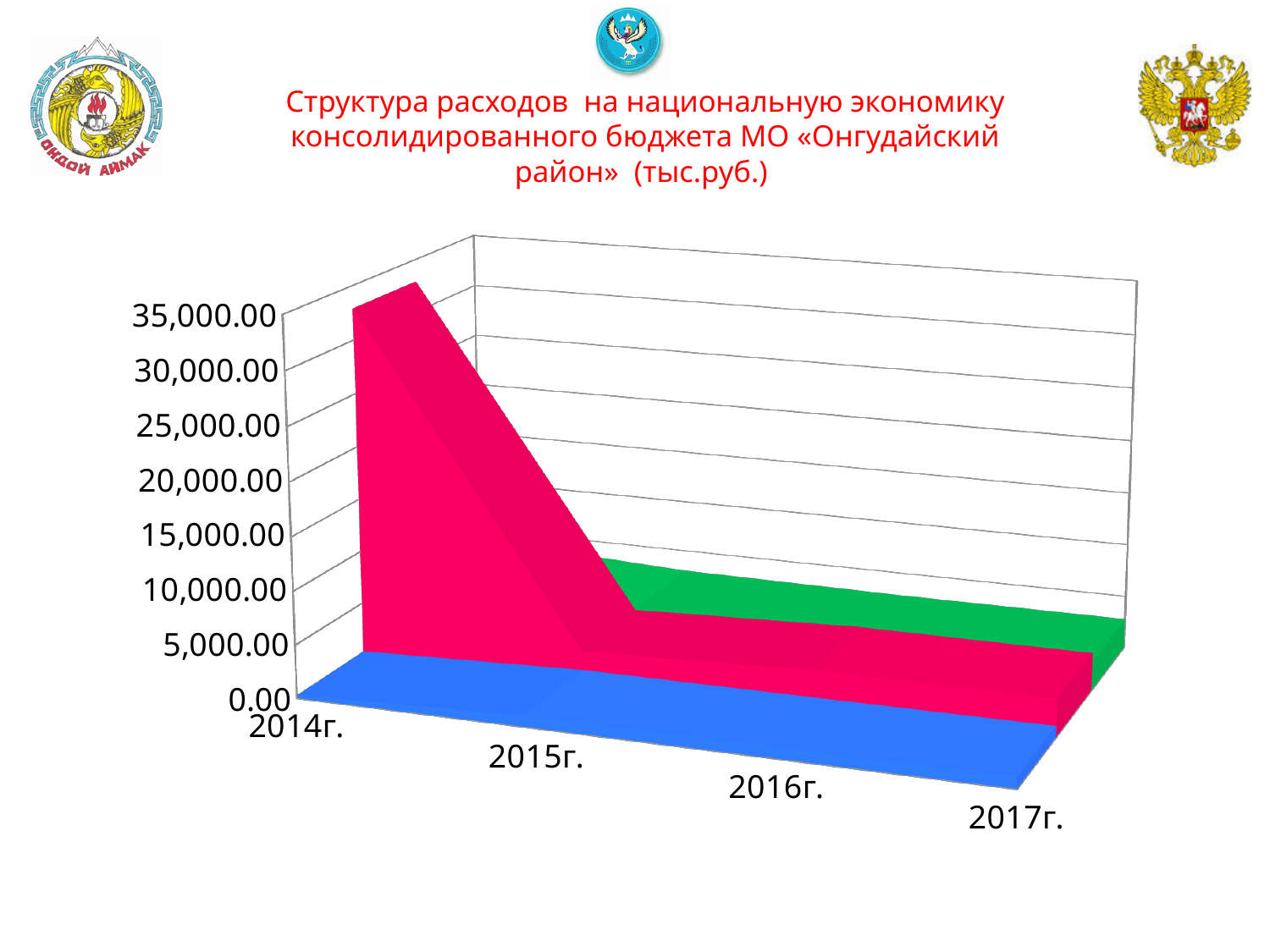
How many years are shown along the x axis of the chart? 4 Which year is the first category on the x axis? 2014г. Is the value of the red series for 2014г. greater or less than 20,000.00? greater Does the red series rise or fall from 2014г. to 2015г.? fall What is the highest value shown on the vertical axis of the chart? 35,000.00 What kind of chart is shown on the slide? area chart In which year does the red series reach its highest value? 2014г.